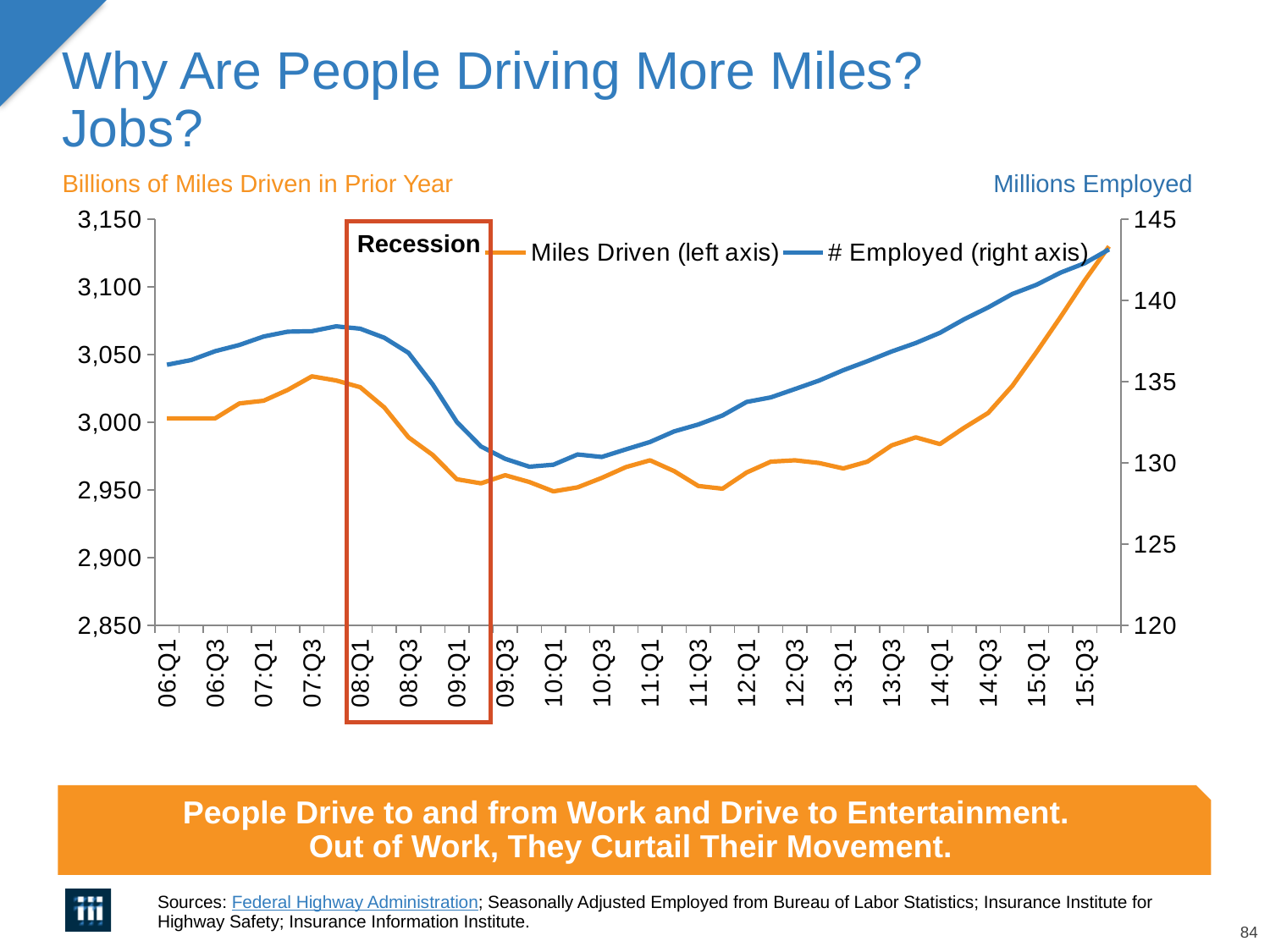
How many series does the legend list? 2 What label appears in the red box on the chart? Recession Which series is plotted against the right axis? # Employed What kind of chart is shown on the slide? line chart Does the Miles Driven series rise or fall between 08:Q1 and 09:Q1? fall Is the value for # Employed at 12:Q1 greater or less than 135? less Does the # Employed series rise or fall between 10:Q1 and 15:Q3? rise Is the value for # Employed at 15:Q3 greater or less than 140? greater Is the value for # Employed at 08:Q1 greater or less than 135? greater At which quarter does the Miles Driven series reach its highest value? 15:Q4